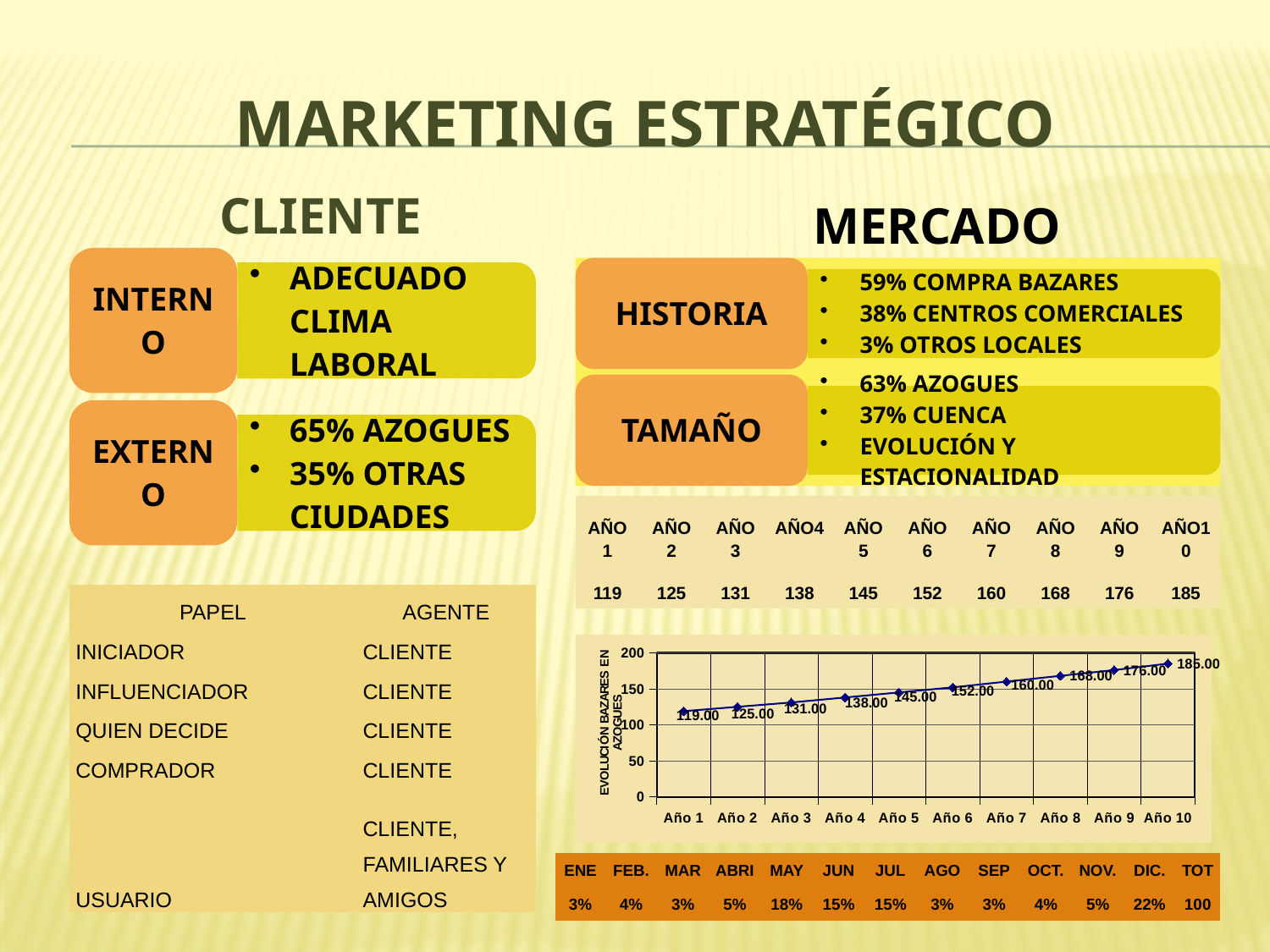
Is the value for Año 3 in the line chart greater or less than 150? less What type of chart is shown on the slide? line chart Which is larger in the line chart, the value for Año 4 or the value for Año 7? Año 7 What is the value plotted for Año 6 in the line chart? 152.00 What is the title of the vertical axis of the line chart? EVOLUCIÓN BAZARES EN AZOGUES How many data points are plotted in the line chart? 10 Which year has the lowest value in the line chart? Año 1 What is the difference between the values for Año 10 and Año 1 in the line chart? 66.00 What is the value plotted for Año 1 in the line chart? 119.00 Which year has the highest value in the line chart? Año 10 What is the value plotted for Año 10 in the line chart? 185.00 Do the values in the line chart rise or fall from Año 1 to Año 10? rise